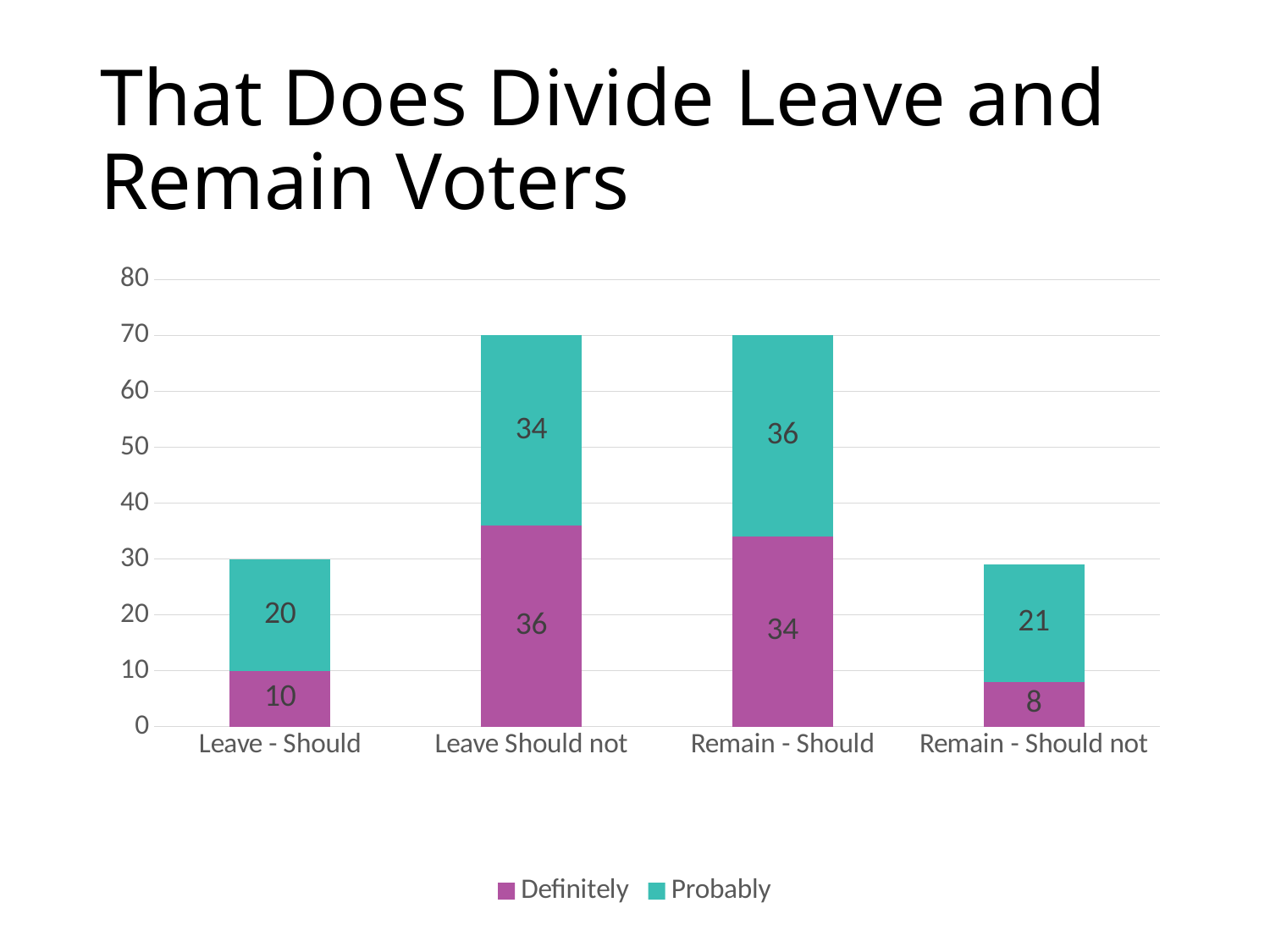
Which category has the lowest Definitely value? Remain - Should not What is the Probably value for Remain - Should? 36 Is the Probably value larger for Leave - Should or for Remain - Should not? Remain - Should not What is the Definitely value for Remain - Should not? 8 Which category has the highest Definitely value? Leave Should not What is the Definitely value for Leave - Should? 10 What is the difference between the Definitely values for Leave Should not and Leave - Should? 26 How many series does the legend list? 2 What is the total of the stacked bar for Remain - Should? 70 What is the total of the stacked bar for Leave - Should? 30 What is the Probably value for Leave Should not? 34 How many categories are shown on the x axis? 4